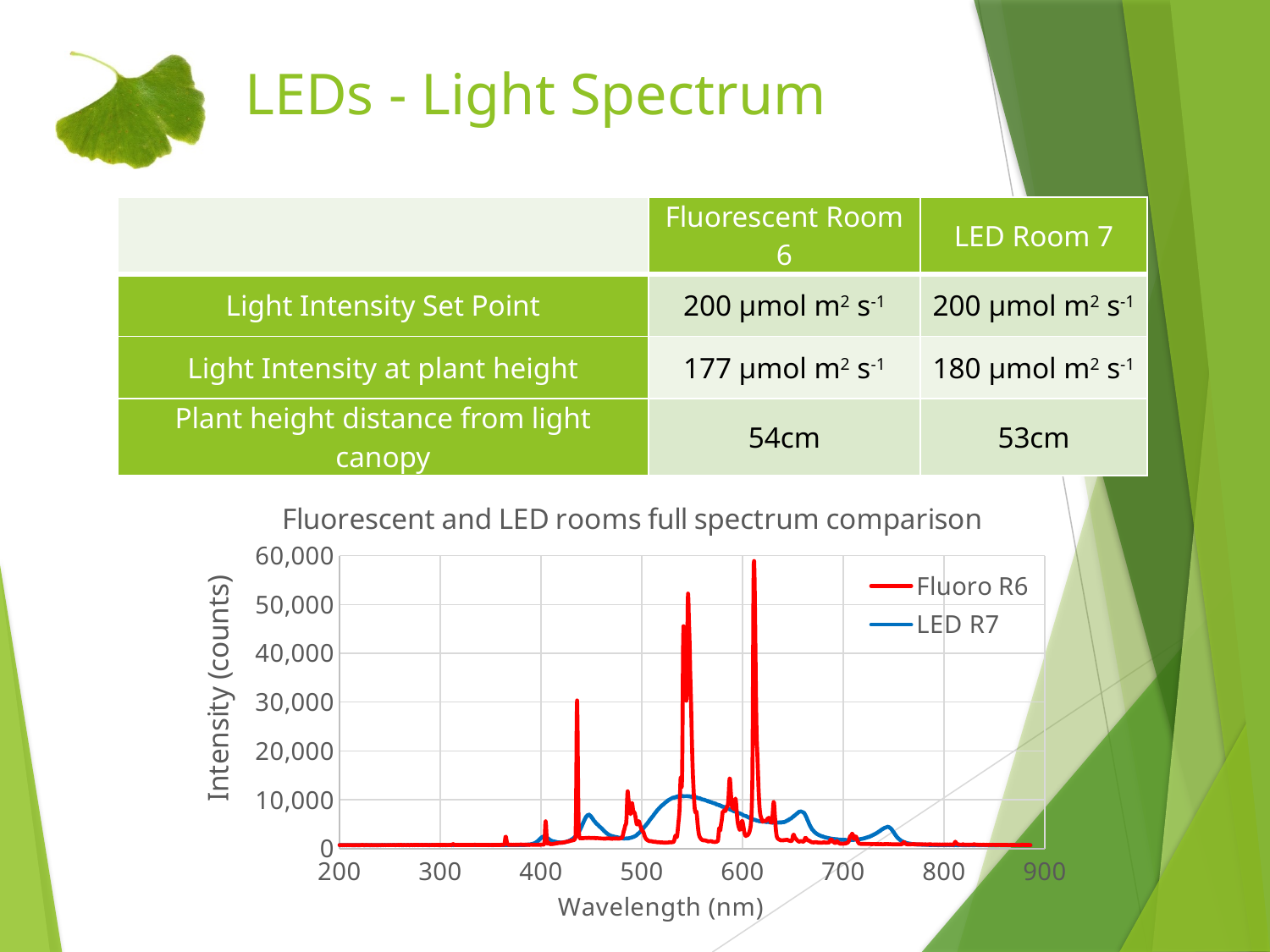
Which series reaches the higher peak intensity, Fluoro R6 or LED R7? Fluoro R6 What is the title of the chart? Fluorescent and LED rooms full spectrum comparison What kind of chart is shown on the slide? line chart Is the Fluoro R6 peak near 435 nm greater or less than 40,000 counts? less How many series does the chart legend list? 2 Is the highest peak of the Fluoro R6 series greater or less than 50,000 counts? greater Is the Fluoro R6 peak near 435 nm greater or less than 20,000 counts? greater What is the label of the x axis of the chart? Wavelength (nm)